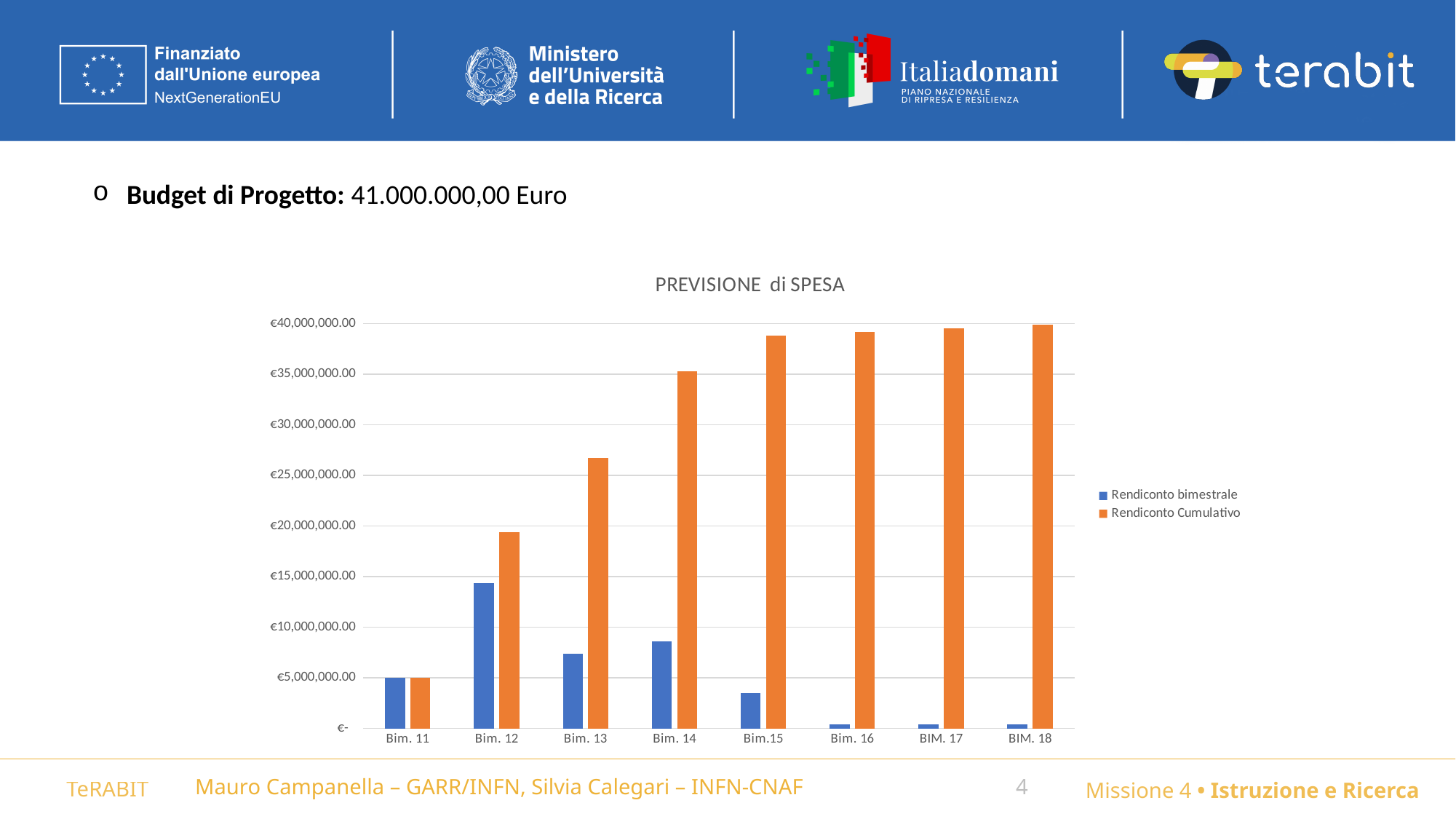
What is the title of the chart? PREVISIONE di SPESA Is the Rendiconto bimestrale value for Bim. 12 greater or less than €10,000,000.00? greater Is the Rendiconto Cumulativo value for Bim. 13 greater or less than €25,000,000.00? greater Which is larger, the Rendiconto bimestrale value for Bim. 12 or for Bim. 14? Bim. 12 Which series is drawn in orange? Rendiconto Cumulativo Which category has the highest value for Rendiconto bimestrale? Bim. 12 Do the Rendiconto Cumulativo values rise or fall from Bim. 11 to BIM. 18? Rise How many categories are shown on the x axis of the chart? 8 How many series does the chart legend list? 2 Is the Rendiconto bimestrale value for Bim.15 greater or less than €5,000,000.00? less What kind of chart is shown on the slide? Bar chart Which category has the lowest value for Rendiconto Cumulativo? Bim. 11